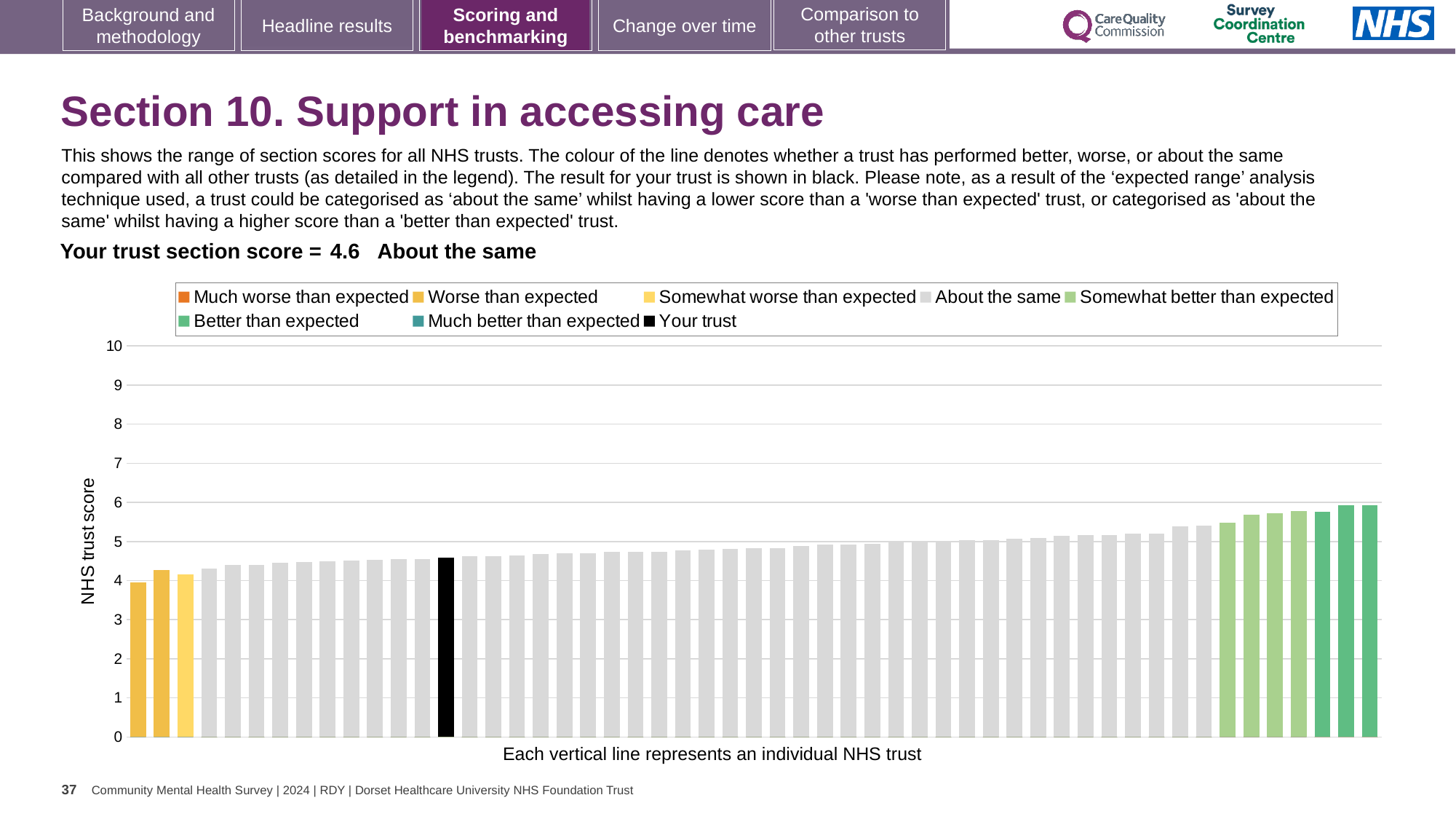
Which category is your trust placed in for this section? About the same Is the value of the tallest bar greater or less than 5? greater What kind of chart is shown on the slide? bar chart Do the bar values rise or fall from left to right along the x axis? rise What is the label of the y axis? NHS trust score What is the highest value shown on the y axis? 10 Is the value of the leftmost bar greater or less than 5? less How many entries does the chart legend list? 8 What is the section score for your trust shown on the slide? 4.6 Is the value for your trust (the black bar) greater or less than 5? less What colour is the bar representing your trust? black